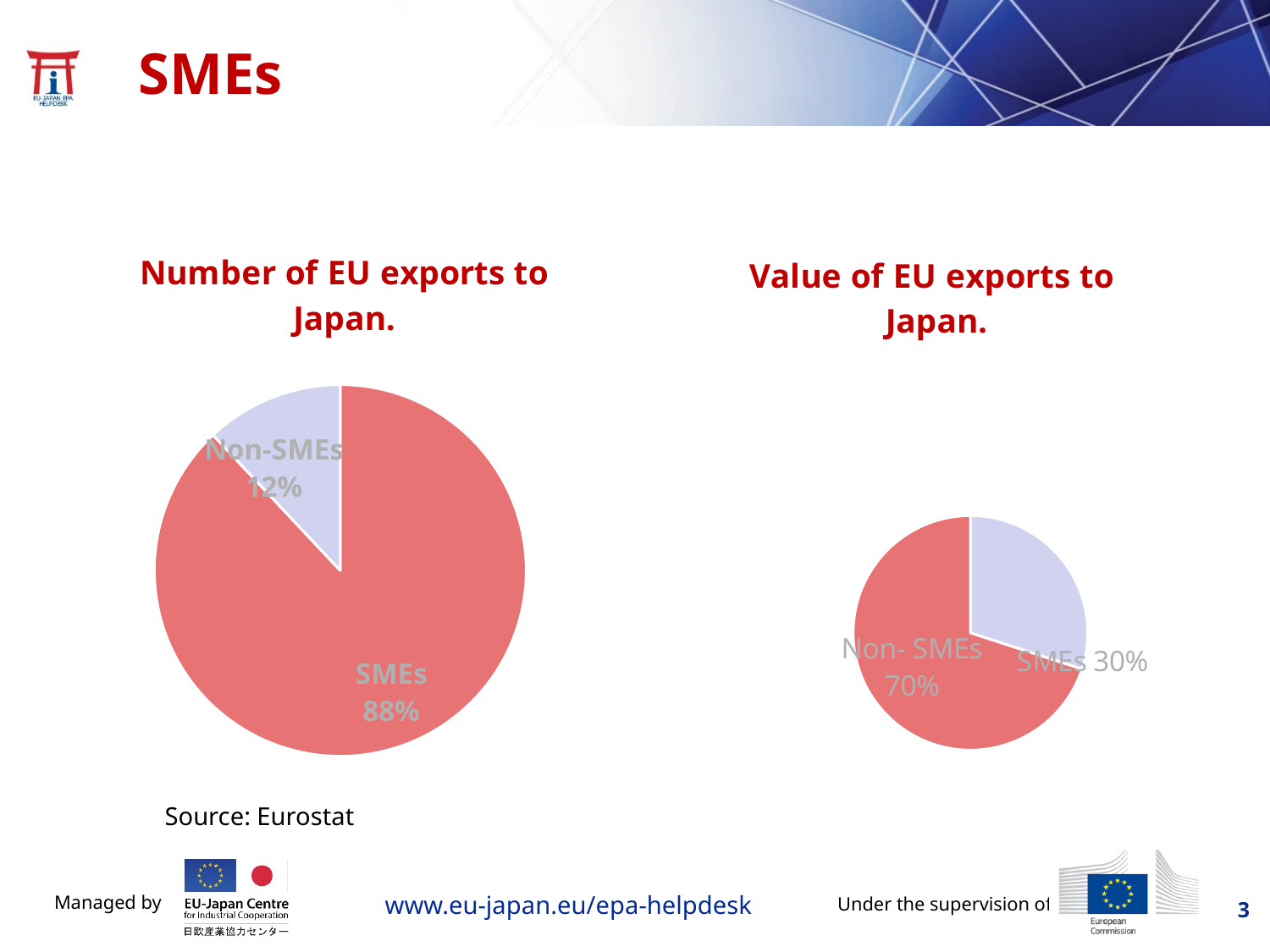
In the 'Value of EU exports to Japan' chart, what share do SMEs account for? 30% Is the SMEs share larger in the 'Number of EU exports to Japan' chart or in the 'Value of EU exports to Japan' chart? Number of EU exports to Japan How many categories are shown in the 'Value of EU exports to Japan' chart? 2 What type of chart is used on the slide for 'Number of EU exports to Japan'? Pie chart In the 'Number of EU exports to Japan' chart, which category has the largest slice? SMEs In the 'Value of EU exports to Japan' chart, what is the difference in percentage points between the Non-SMEs and SMEs shares? 40 In the 'Value of EU exports to Japan' chart, what share do Non-SMEs account for? 70% In the 'Number of EU exports to Japan' chart, what is the difference in percentage points between the SMEs and Non-SMEs shares? 76 In the 'Value of EU exports to Japan' chart, which category has the smallest slice? SMEs In the 'Number of EU exports to Japan' chart, what share do SMEs account for? 88% What is the data source cited on the slide for the charts? Eurostat In the 'Number of EU exports to Japan' chart, what share do Non-SMEs account for? 12%